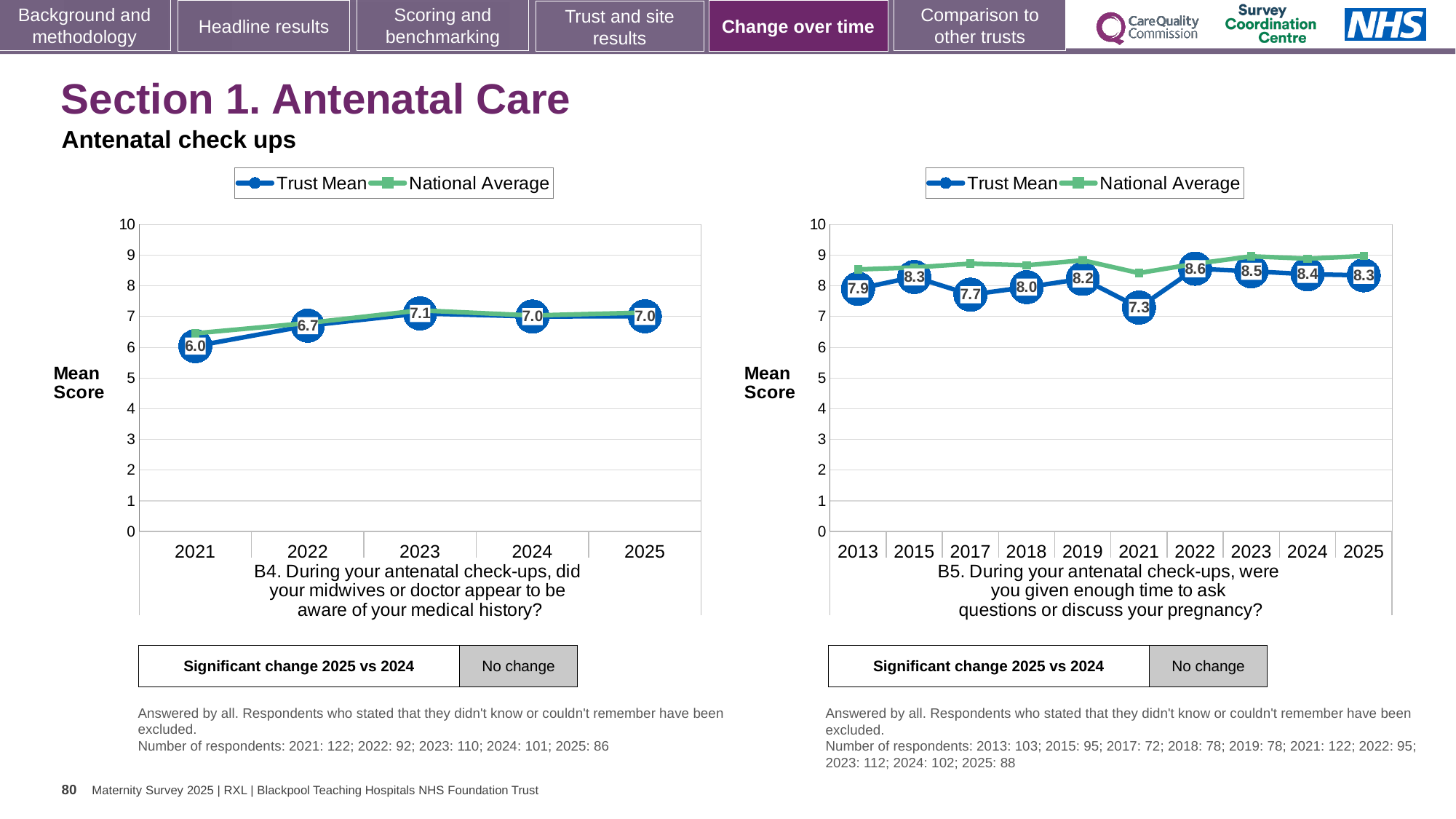
In the B5 chart on the right, which year has the lowest Trust Mean score? 2021 In the B4 chart on the left, what is the difference between the Trust Mean scores for 2023 and 2021? 1.1 In the B4 chart on the left, how many years are shown on the x axis? 5 In the B5 chart on the right, is the Trust Mean score for 2022 or 2017 larger? 2022 In the B5 chart on the right, how many series does the legend list? 2 In the B5 chart on the right, which year has the highest Trust Mean score? 2022 What kind of chart is the B4 chart on the left? Line chart In the B4 chart on the left, what is the Trust Mean score for 2021? 6.0 In the B5 chart on the right, what is the Trust Mean score for 2021? 7.3 In the B4 chart on the left, which year has the lowest Trust Mean score? 2021 In the B5 chart on the right, what is the difference between the Trust Mean scores for 2022 and 2021? 1.3 In the B4 chart on the left, what is the Trust Mean score for 2023? 7.1